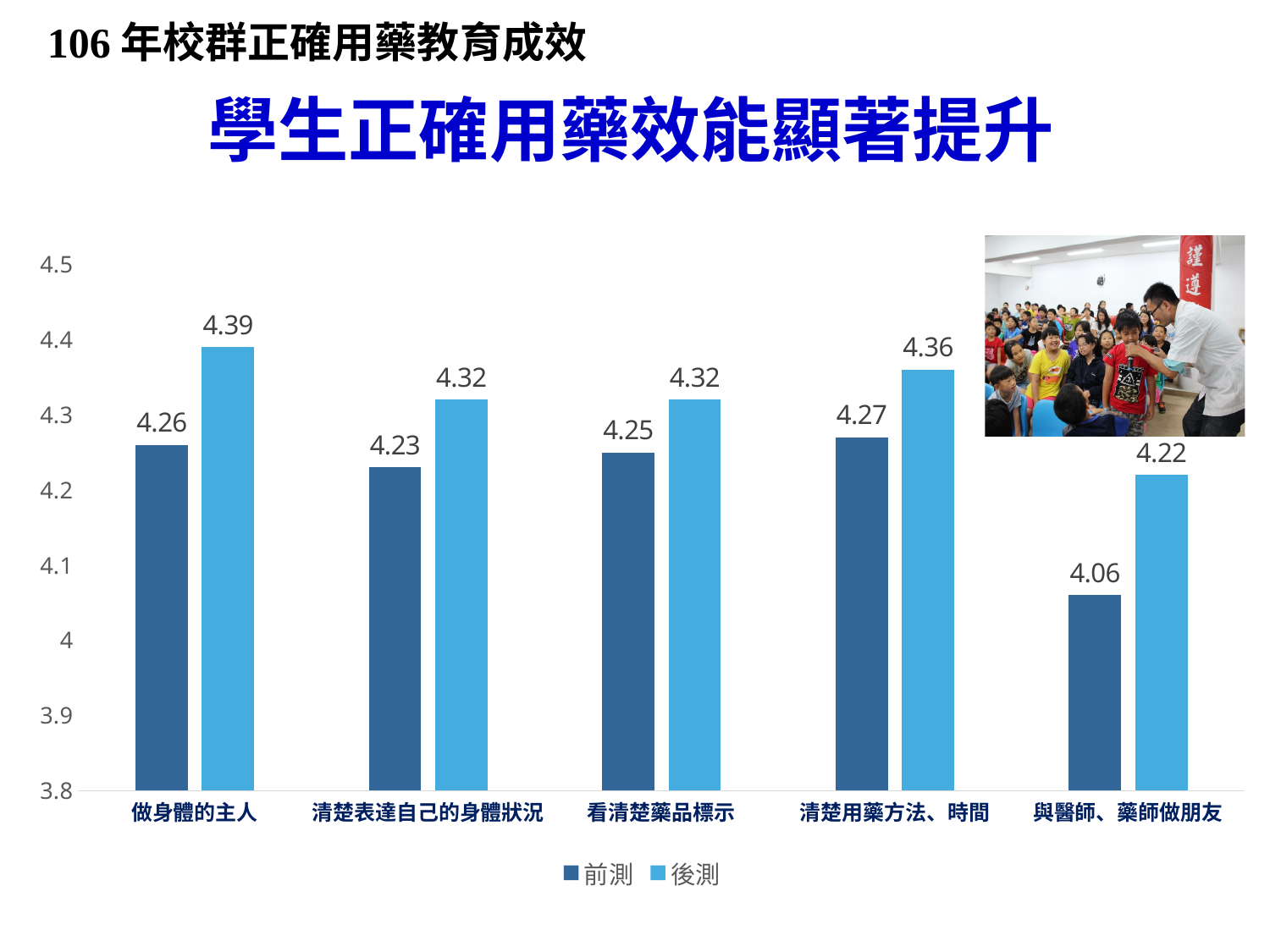
Which category has the highest 後測 value? 做身體的主人 What is the 後測 value for 清楚用藥方法、時間? 4.36 What kind of chart is shown on the slide? bar chart Which category has the lowest 前測 value? 與醫師、藥師做朋友 How many categories are shown on the x axis? 5 What is the 前測 value for 做身體的主人? 4.26 What is the difference between the 後測 and 前測 values for 做身體的主人? 0.13 What is the difference between the 後測 and 前測 values for 與醫師、藥師做朋友? 0.16 How many series does the legend list? 2 What is the 後測 value for 與醫師、藥師做朋友? 4.22 Which is larger for 看清楚藥品標示, the 前測 value or the 後測 value? 後測 Is the 前測 value for 與醫師、藥師做朋友 greater or less than 4.1? less